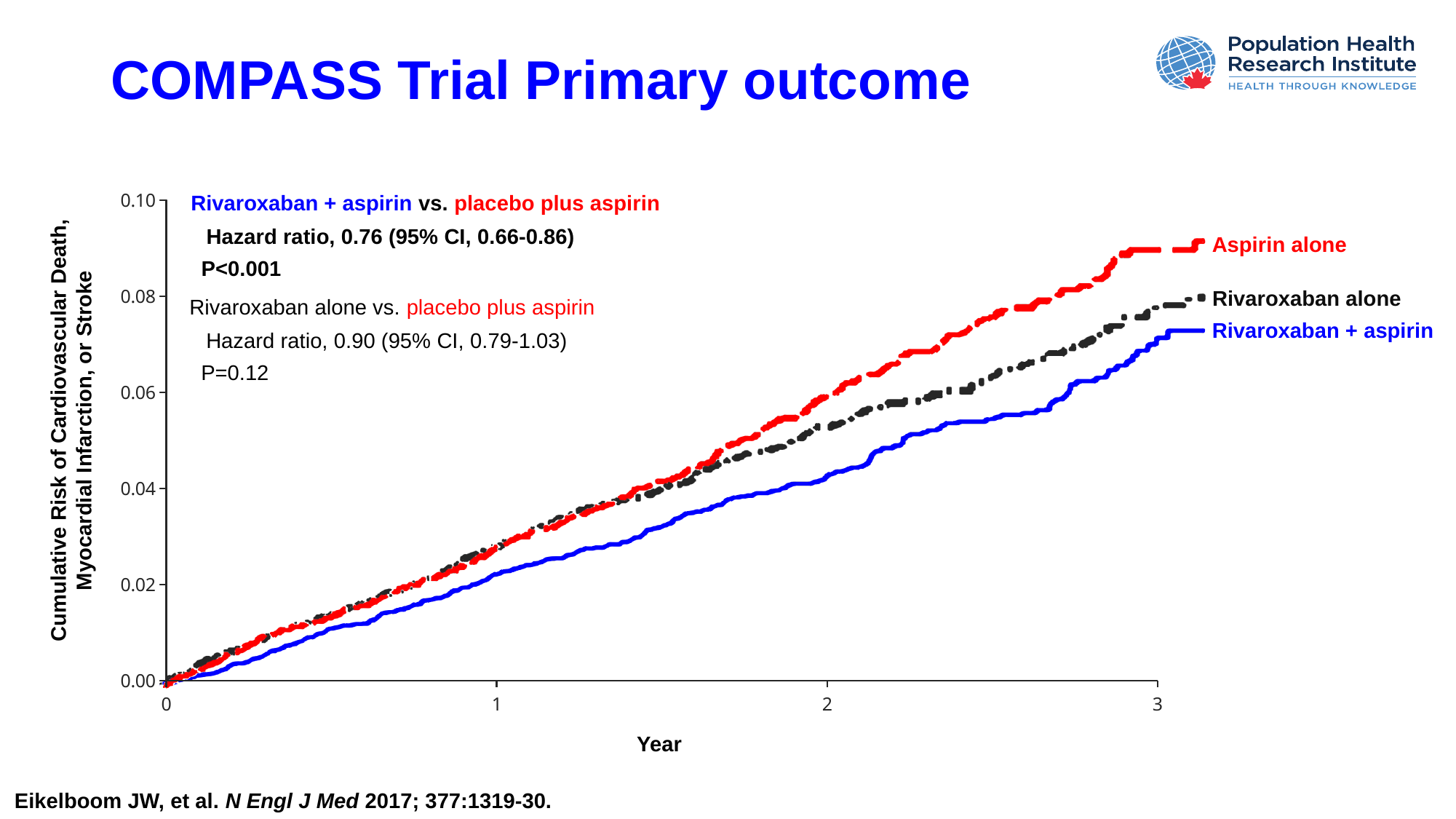
Which treatment group has the highest cumulative risk at year 3? Aspirin alone What is the label of the x axis? Year Do the cumulative risk curves rise or fall as the years increase? rise At year 3, which has the higher cumulative risk: Aspirin alone or Rivaroxaban + aspirin? Aspirin alone Is the cumulative risk for Aspirin alone at year 2 greater or less than 0.04? greater What colour is the line for Rivaroxaban + aspirin? blue Is the cumulative risk for Rivaroxaban + aspirin at year 2 greater or less than 0.06? less Is the cumulative risk for Aspirin alone at year 3 greater or less than 0.08? greater What kind of chart is shown on the slide? line chart Which treatment group has the lowest cumulative risk at year 3? Rivaroxaban + aspirin How many series (treatment groups) are plotted on the chart? 3